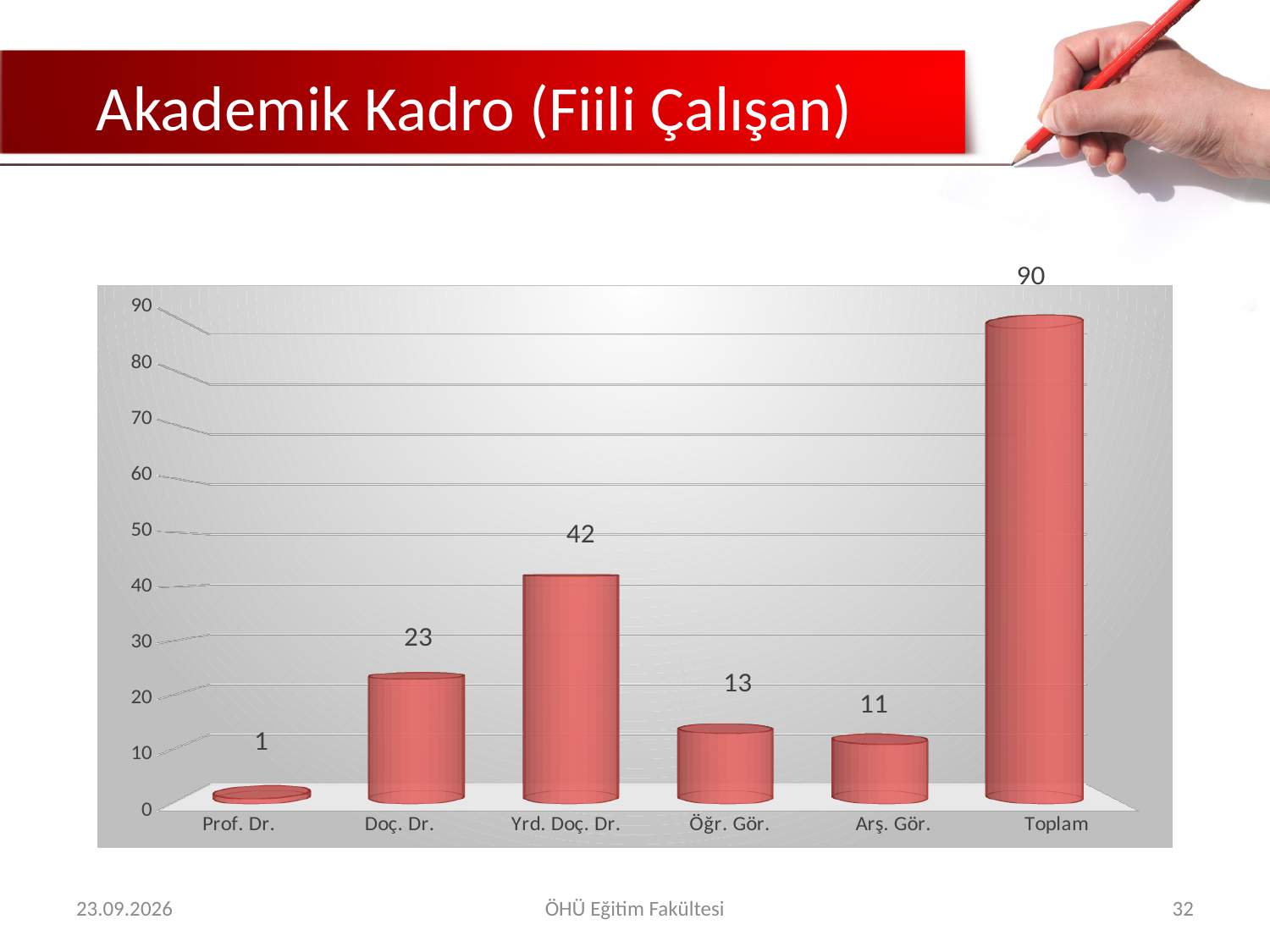
Which category has the lowest value? Prof. Dr. Is the value for Yrd. Doç. Dr. greater or less than 40? greater What kind of chart is shown on the slide? bar chart What is the title of the slide containing the chart? Akademik Kadro (Fiili Çalışan) What is the value for Prof. Dr.? 1 What is the value for Doç. Dr.? 23 What is the value for Yrd. Doç. Dr.? 42 Which category has the highest value? Toplam Which is larger, the value for Öğr. Gör. or the value for Arş. Gör.? Öğr. Gör. What is the difference between the values for Yrd. Doç. Dr. and Doç. Dr.? 19 How many categories are shown on the x axis? 6 What is the value for Arş. Gör.? 11